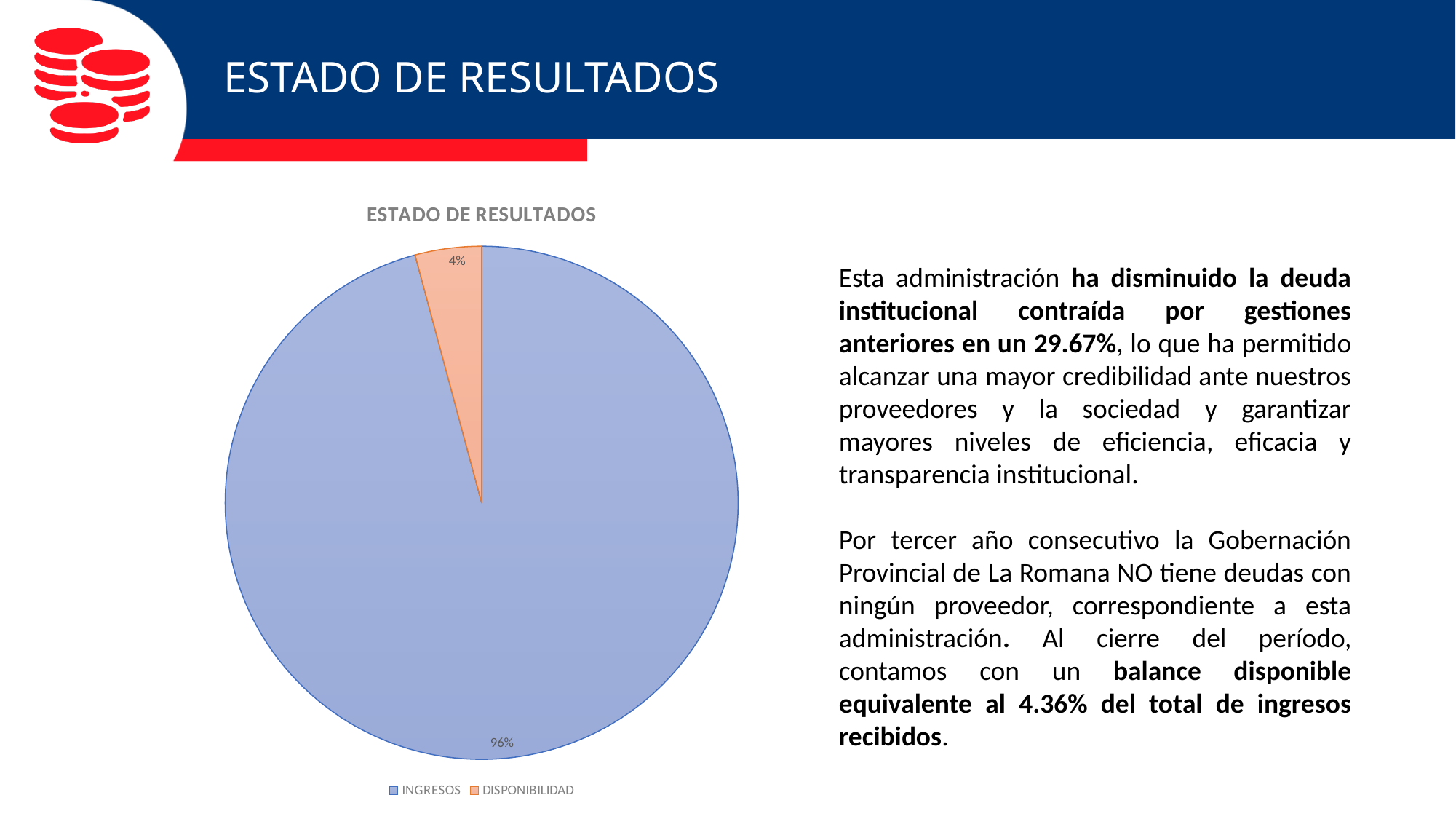
What kind of chart is shown on the slide? pie chart How many slices does the pie chart have? 2 What share of the pie does DISPONIBILIDAD represent? 4% What is the title of the chart? ESTADO DE RESULTADOS Which slice of the pie is the largest? INGRESOS How many entries does the legend list? 2 Which slice of the pie is the smallest? DISPONIBILIDAD What share of the pie does INGRESOS represent? 96% What is the difference in percentage points between the INGRESOS and DISPONIBILIDAD slices? 92 What colour is the DISPONIBILIDAD slice? orange Which is larger, the INGRESOS slice or the DISPONIBILIDAD slice? INGRESOS